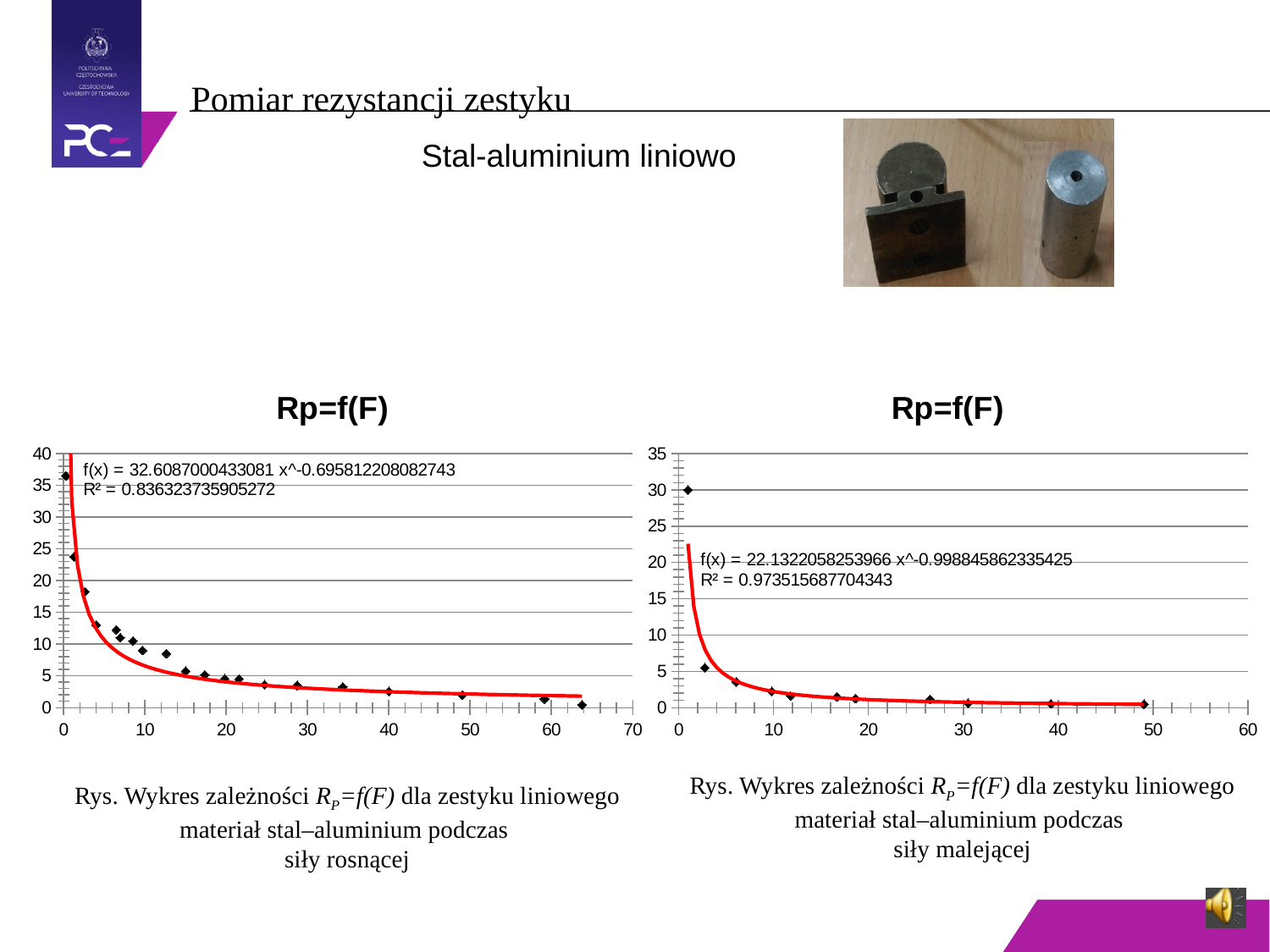
In the left chart, is the value of the first plotted point (near x = 0) greater or less than 30? greater In the right chart, do the plotted values rise or fall as the x-axis value increases? fall What is the R² value shown on the left chart? 0.836323735905272 In the right chart, is the value of the point near x = 10 greater or less than 10? less What type of chart is the left chart titled Rp=f(F)? scatter chart What is the R² value shown on the right chart? 0.973515687704343 In the left chart, is the value of the last plotted point (near x = 63) greater or less than 5? less What is the maximum value shown on the x-axis of the right chart? 60 In the left chart, do the plotted values rise or fall as the x-axis value increases? fall What type of chart is the right chart titled Rp=f(F)? scatter chart